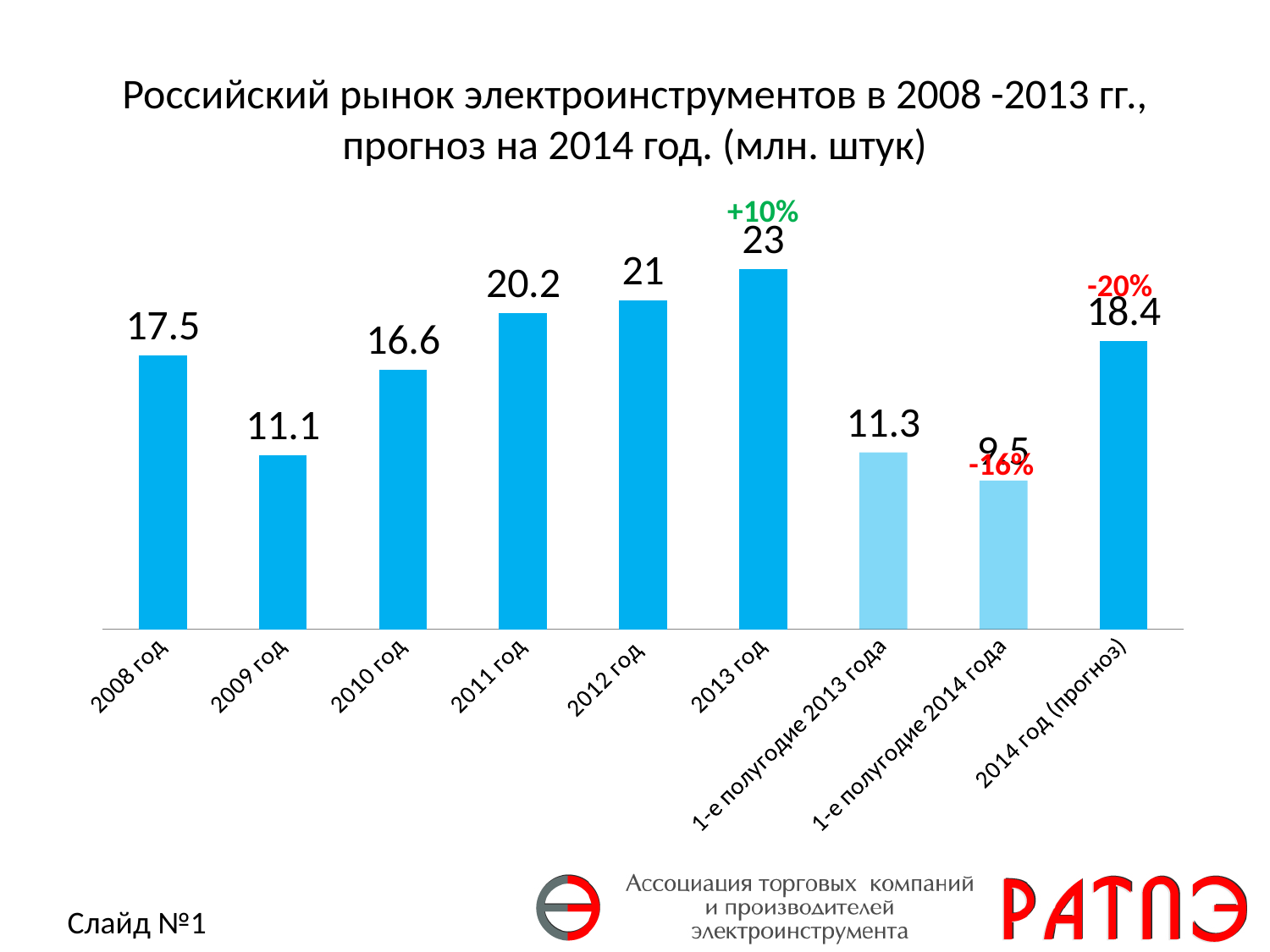
What is the difference between the values for 2008 год and 2009 год? 6.4 What kind of chart is shown on the slide? Bar chart Which category has the highest value? 2013 год What is the value for 1-е полугодие 2013 года? 11.3 Which category has the lowest value? 1-е полугодие 2014 года What is the value for 2011 год? 20.2 What is the difference between the values for 2013 год and 2012 год? 2 How many bars are shown in the chart? 9 What is the value for 2014 год (прогноз)? 18.4 Which is larger, the value for 2010 год or the value for 2008 год? 2008 год What is the value for 2008 год? 17.5 What percentage change label is shown above the 2013 год bar? +10%